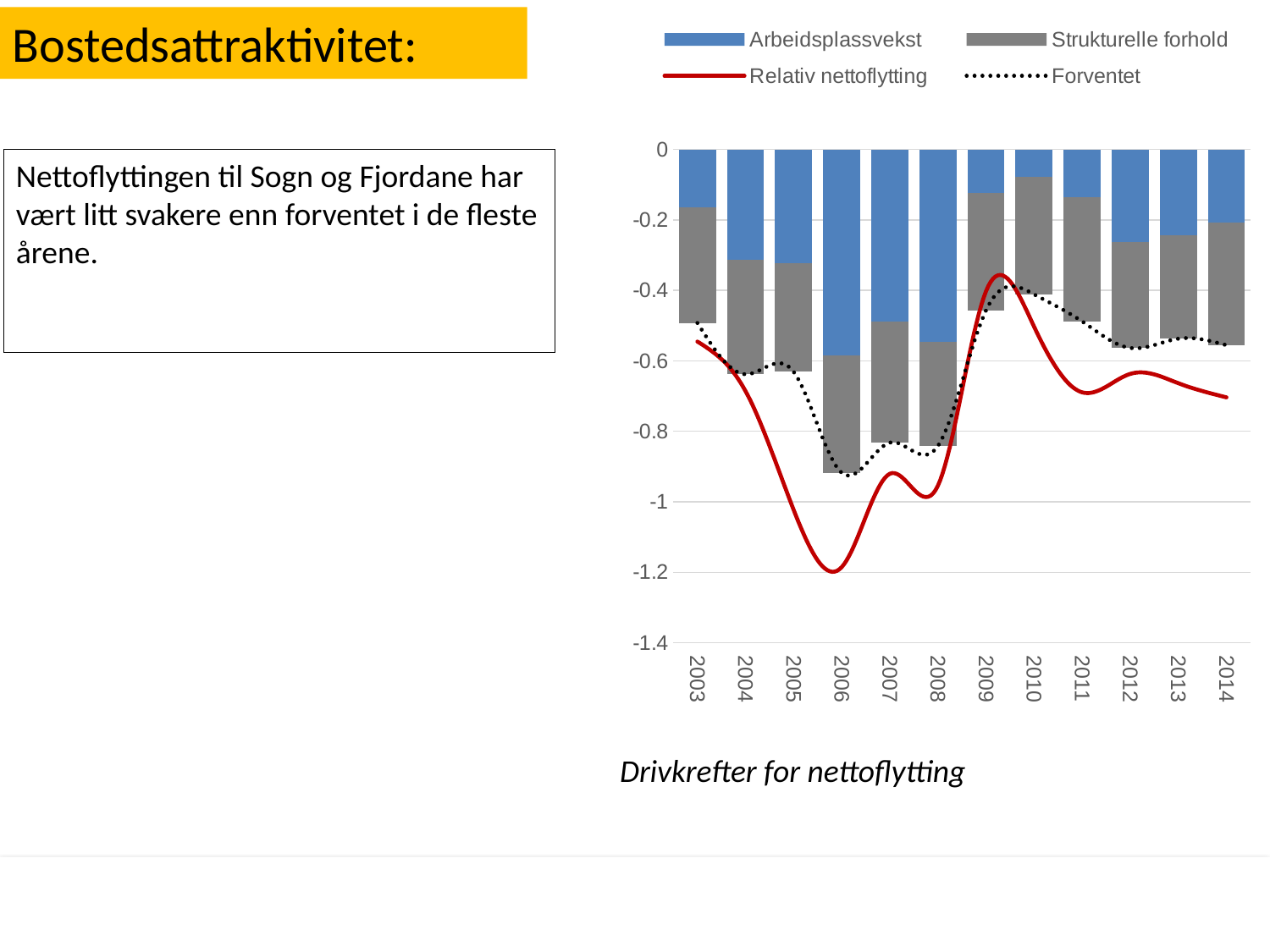
Which colour represents Arbeidsplassvekst in the chart? blue Which year has the larger Arbeidsplassvekst (blue) segment, 2003 or 2006? 2006 In which year does the Relativ nettoflytting line reach its lowest point? 2006 Which year has the longest stacked bar (the most negative total)? 2006 Is the Relativ nettoflytting value in 2006 greater or less than -1? less Is the total of the stacked bar for 2010 greater or less than -0.6? greater What is the caption printed below the chart? Drivkrefter for nettoflytting Is the Relativ nettoflytting value in 2009 greater or less than -0.6? greater How many series does the chart legend list? 4 Does the Relativ nettoflytting line rise or fall from 2003 to 2006? fall What kind of chart is shown on the slide? bar and line chart How many years are shown on the x axis of the chart? 12